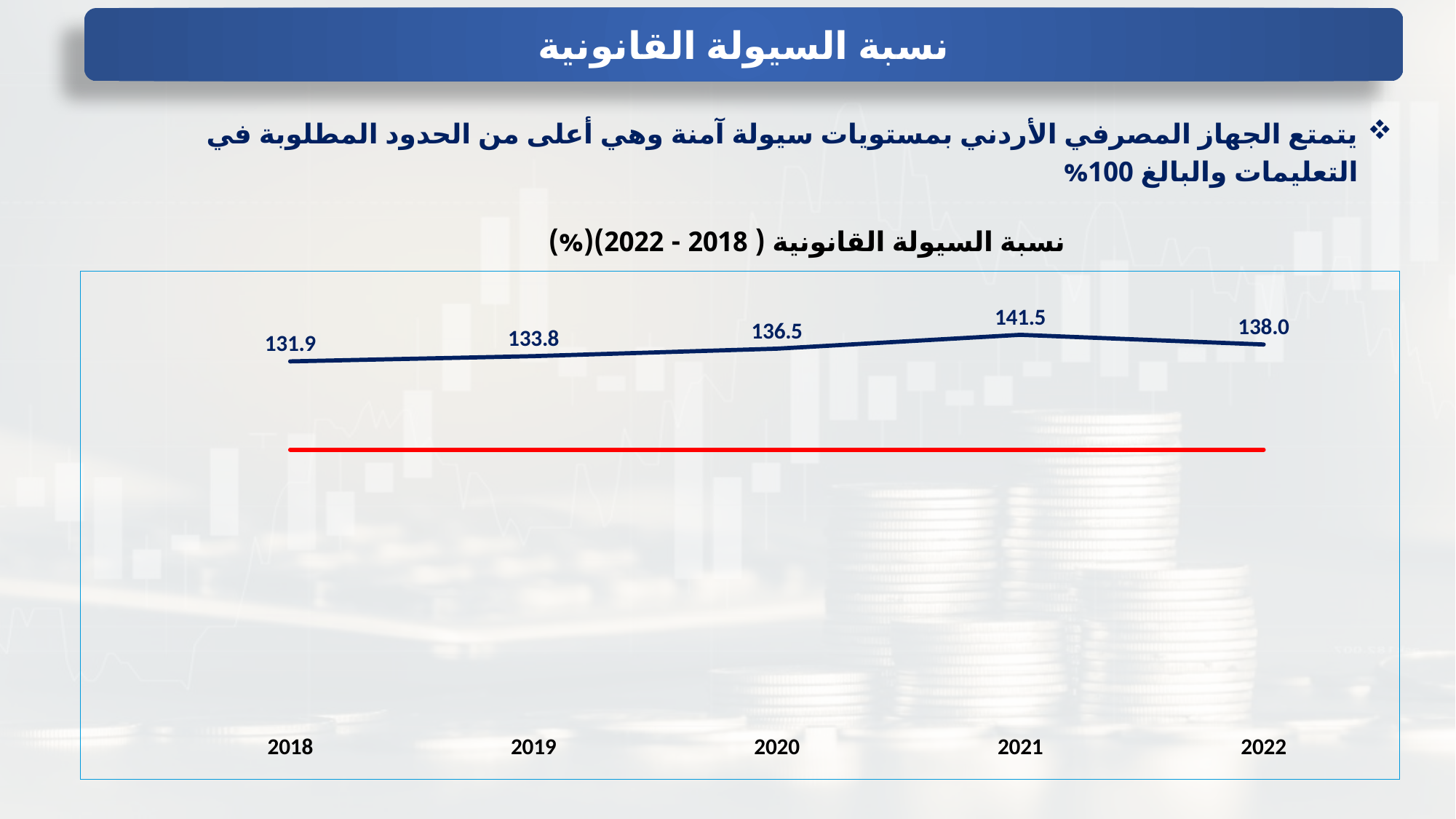
What kind of chart is shown on the slide? line chart In which year is the legal liquidity ratio lowest? 2018 What is the legal liquidity ratio value shown for 2022? 138.0 What is the legal liquidity ratio value shown for 2018? 131.9 Does the legal liquidity ratio rise or fall from 2018 to 2021? rise What is the legal liquidity ratio value shown for 2020? 136.5 In which year is the legal liquidity ratio highest? 2021 Which year has a higher legal liquidity ratio, 2020 or 2022? 2022 What is the legal liquidity ratio value shown for 2021? 141.5 How many years are plotted on the x axis of the chart? 5 What is the difference between the 2019 and 2018 legal liquidity ratio values? 1.9 What is the difference between the 2021 and 2022 legal liquidity ratio values? 3.5